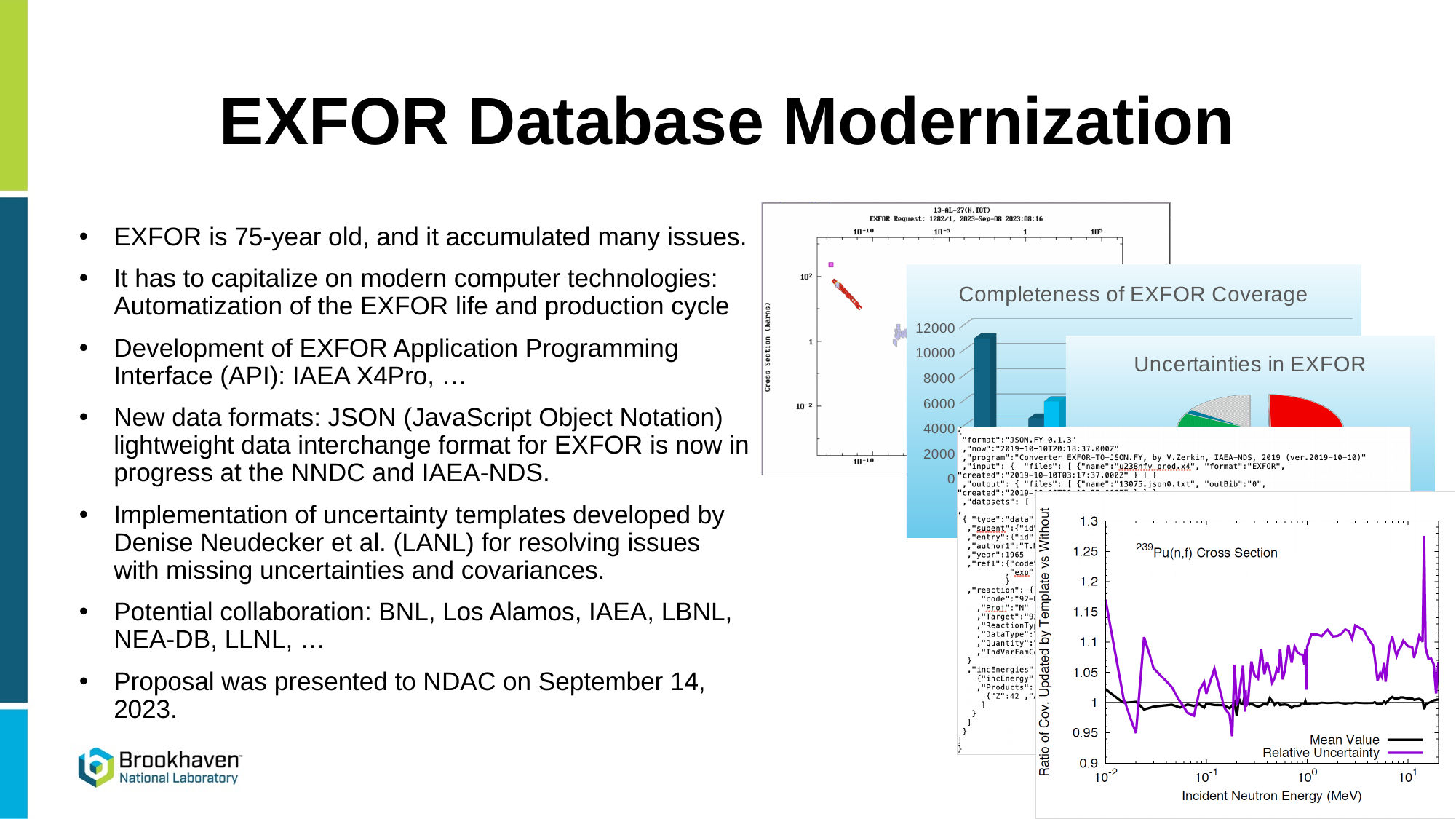
What kind of chart is the '239Pu(n,f) Cross Section' chart in the bottom right? line chart What is the title of the bar chart on the slide? Completeness of EXFOR Coverage In the '239Pu(n,f) Cross Section' chart, which series is plotted in purple? Relative Uncertainty How many series does the legend of the '239Pu(n,f) Cross Section' chart list? 2 What kind of chart is the 'Uncertainties in EXFOR' chart? pie chart In the 'Completeness of EXFOR Coverage' chart, what is the highest value shown on the vertical axis? 12000 In the '239Pu(n,f) Cross Section' chart, which series reaches the higher maximum value, Mean Value or Relative Uncertainty? Relative Uncertainty In the 'Completeness of EXFOR Coverage' chart, is the value of the tallest (leftmost) bar greater or less than 10000? greater In the '239Pu(n,f) Cross Section' chart, is the peak value of the Relative Uncertainty series greater or less than 1.2? greater In the '239Pu(n,f) Cross Section' chart, is the Mean Value series at an incident neutron energy of 10^0 MeV greater or less than 1.1? less What kind of chart is the 'Completeness of EXFOR Coverage' chart? bar chart